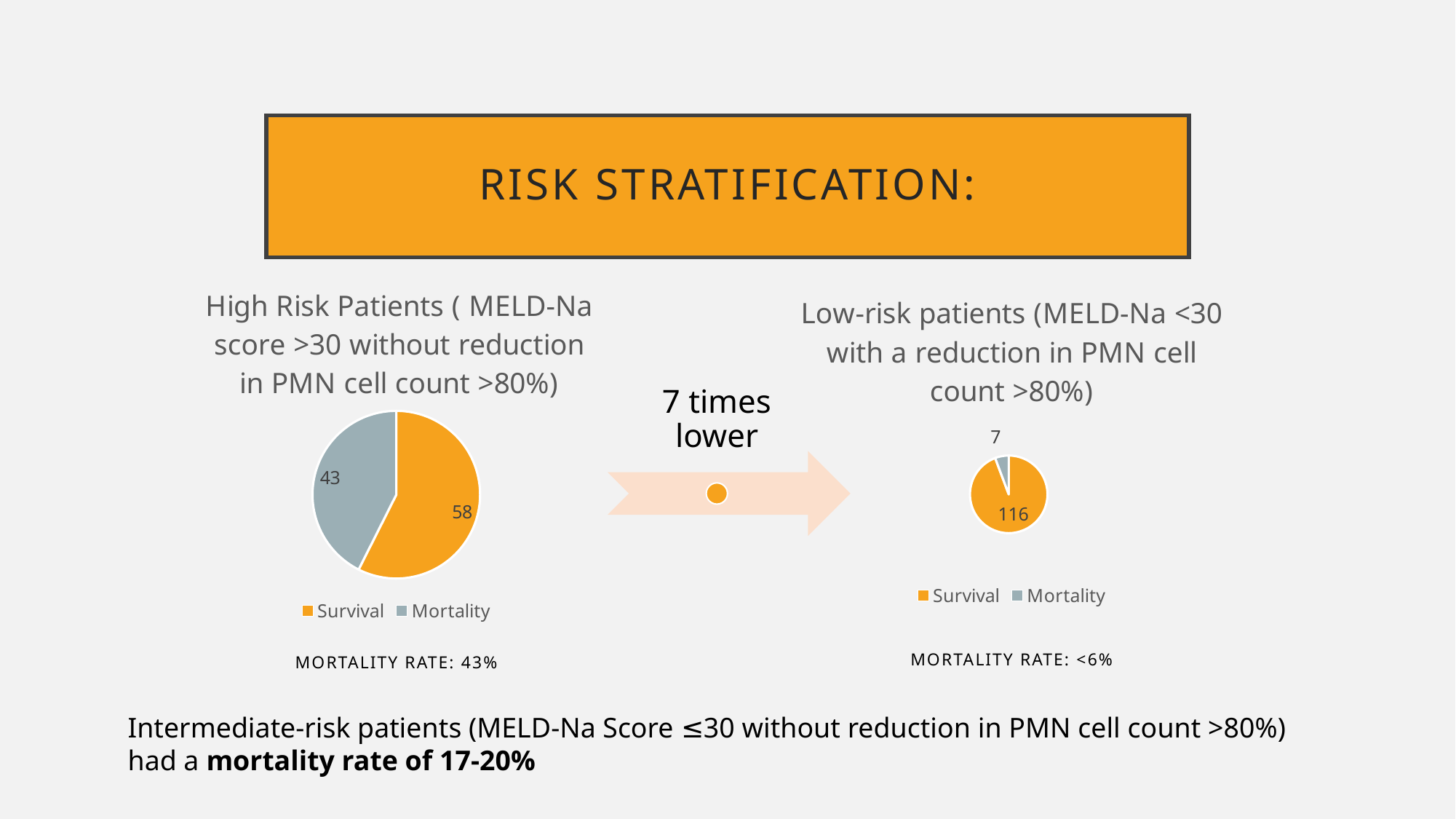
In the Low-risk patients pie chart, which colour represents Survival? Orange In the Low-risk patients pie chart, what is the value for Mortality? 7 In the High Risk Patients pie chart, what is the difference between the Survival and Mortality values? 15 What type of chart is used for the High Risk Patients data? Pie chart In the High Risk Patients pie chart, what share of the pie does the Mortality slice represent, as stated on the slide? 43% In the Low-risk patients pie chart, what is the value for Survival? 116 In the High Risk Patients pie chart, what is the value for Mortality? 43 In the High Risk Patients pie chart, which slice is larger, Survival or Mortality? Survival How many series does the legend of the Low-risk patients chart list? 2 In the High Risk Patients pie chart, what is the value for Survival? 58 In the Low-risk patients pie chart, which slice is the smallest? Mortality In the Low-risk patients pie chart, what is the difference between the Survival and Mortality values? 109